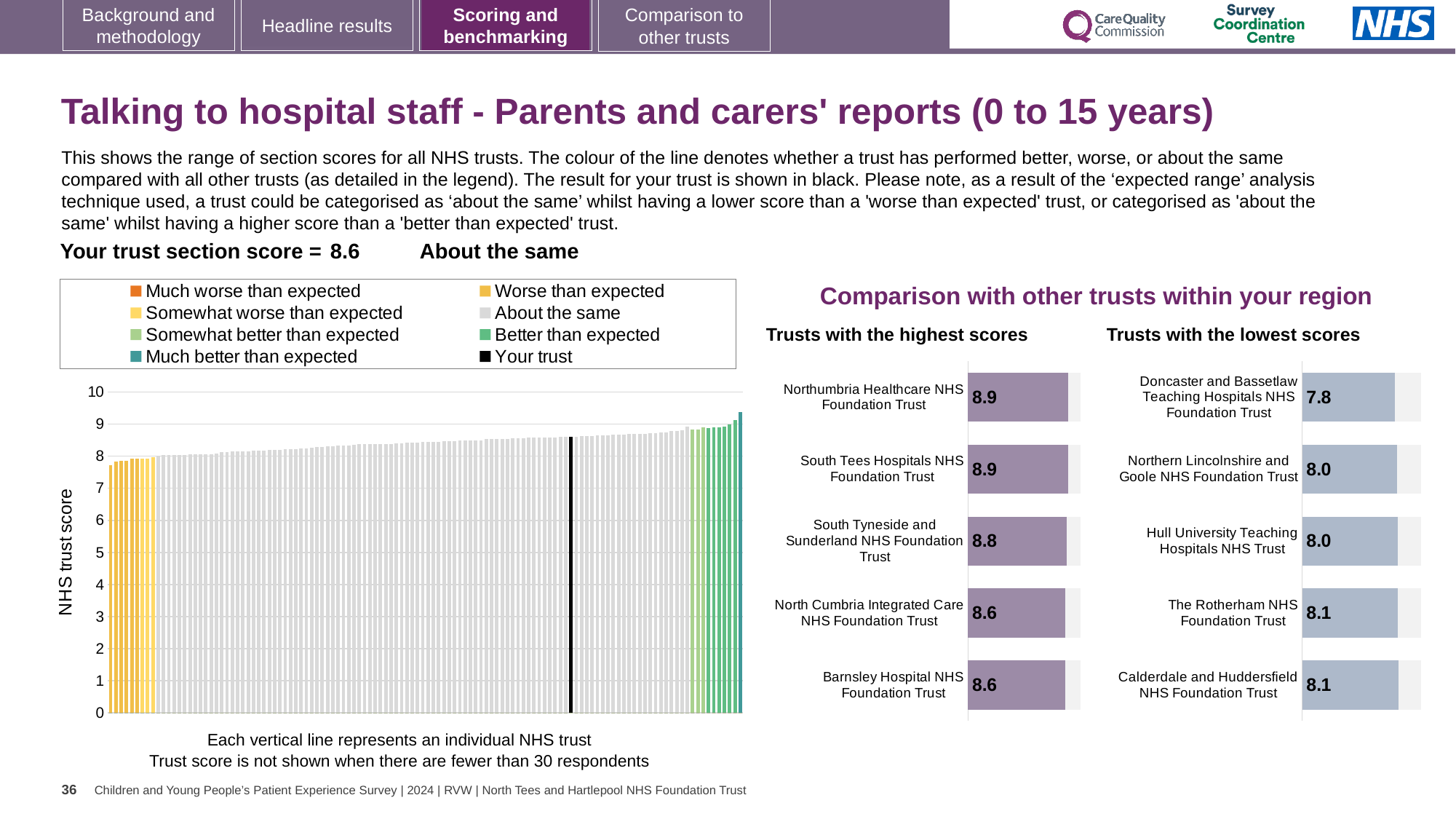
In the 'Trusts with the lowest scores' chart, which trust has the lowest score? Doncaster and Bassetlaw Teaching Hospitals NHS Foundation Trust In the 'Trusts with the lowest scores' chart, what is the difference between the scores of Calderdale and Huddersfield NHS Foundation Trust and Doncaster and Bassetlaw Teaching Hospitals NHS Foundation Trust? 0.3 In the 'Trusts with the highest scores' chart, what is the score for South Tyneside and Sunderland NHS Foundation Trust? 8.8 In the 'Trusts with the lowest scores' chart, what is the score for Hull University Teaching Hospitals NHS Trust? 8.0 In the 'Trusts with the highest scores' chart, which has the higher score: South Tyneside and Sunderland NHS Foundation Trust or North Cumbria Integrated Care NHS Foundation Trust? South Tyneside and Sunderland NHS Foundation Trust On the large chart on the left, is the value for the black 'Your trust' bar greater or less than 8? greater On the large chart on the left, what is the label of the vertical axis? NHS trust score In the 'Trusts with the highest scores' chart, how many trusts are shown? 5 What kind of chart is the large chart on the left of the slide? bar chart How many entries does the legend above the large chart on the left list? 8 In the 'Trusts with the highest scores' chart, what is the score for Barnsley Hospital NHS Foundation Trust? 8.6 In the 'Trusts with the highest scores' chart, what is the difference between the scores of Northumbria Healthcare NHS Foundation Trust and Barnsley Hospital NHS Foundation Trust? 0.3